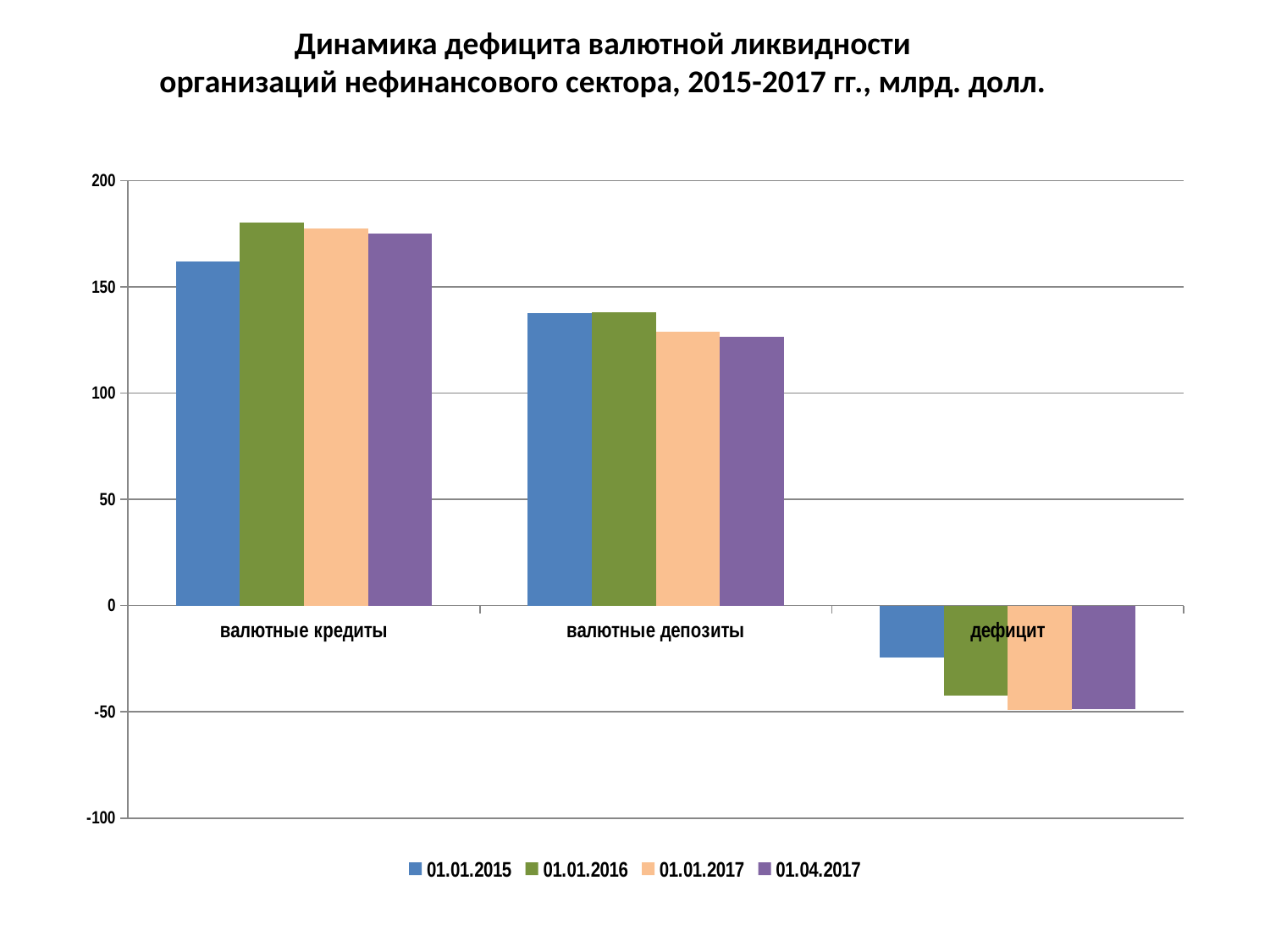
For валютные депозиты, which is larger: the value on 01.01.2016 or on 01.04.2017? 01.01.2016 Which category has the lowest (negative) values? дефицит Is the value for валютные кредиты on 01.01.2015 greater or less than 150? greater How many categories are shown on the x axis? 3 For валютные кредиты, which is larger: the value on 01.01.2015 or on 01.01.2016? 01.01.2016 Which category has the highest values? валютные кредиты Which colour represents the 01.04.2017 series in the legend? purple Within валютные кредиты, which series has the lowest value? 01.01.2015 How many series does the legend list? 4 Is the value for валютные депозиты on 01.04.2017 greater or less than 150? less Is the value for дефицит on 01.01.2016 greater or less than 0? less What kind of chart is shown on the slide? bar chart